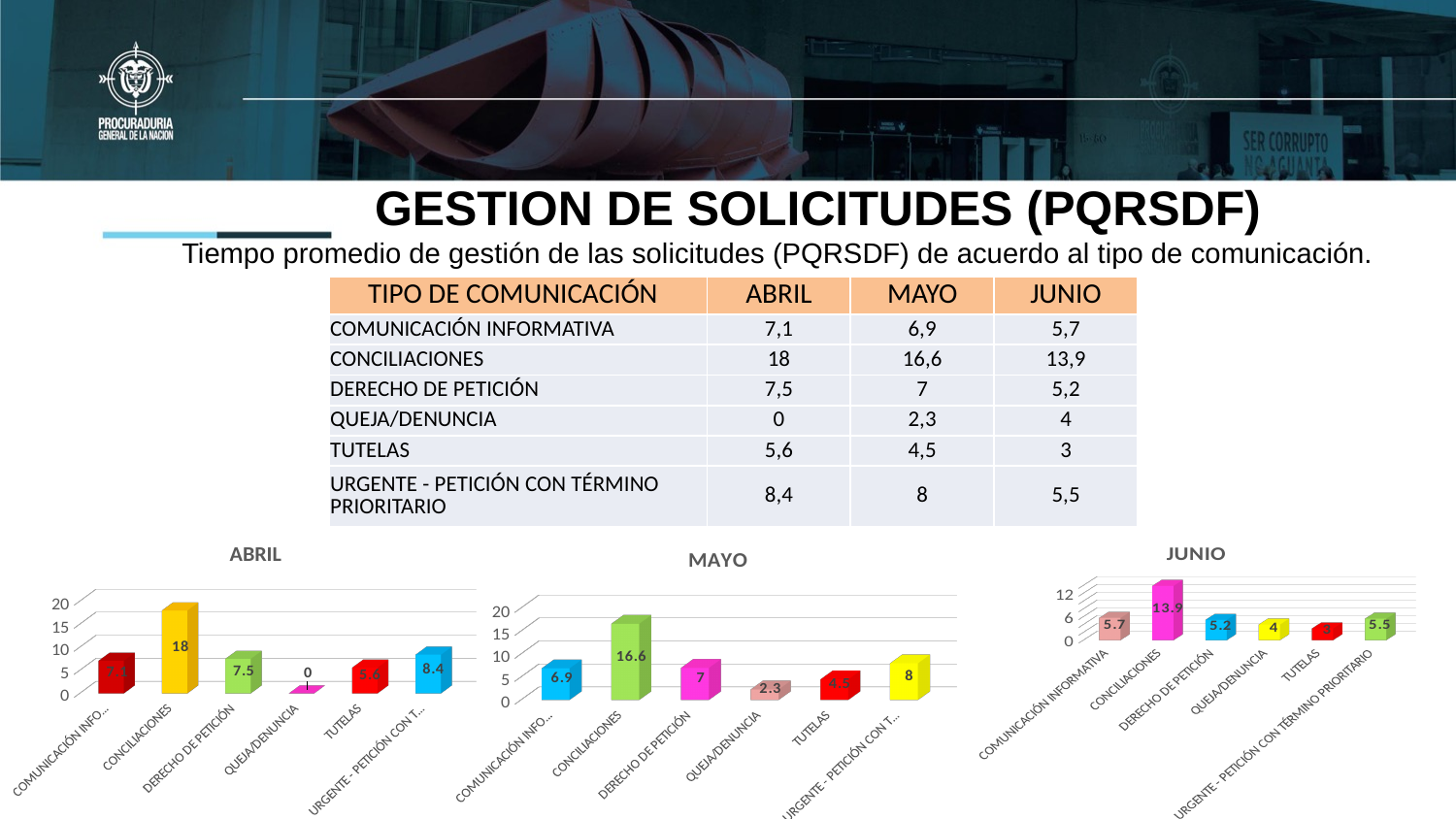
In the MAYO chart, which category has the highest value? CONCILIACIONES In the ABRIL chart, what is the value for CONCILIACIONES? 18 In the MAYO chart, what is the value for CONCILIACIONES? 16.6 In the ABRIL chart, which category has the lowest value? QUEJA/DENUNCIA In the JUNIO chart, is the value for CONCILIACIONES greater or less than 12? greater In the MAYO chart, what is the value for QUEJA/DENUNCIA? 2.3 In the JUNIO chart, which is larger, the value for DERECHO DE PETICIÓN or the value for QUEJA/DENUNCIA? DERECHO DE PETICIÓN In the JUNIO chart, what is the value for CONCILIACIONES? 13.9 In the ABRIL chart, what is the value for URGENTE - PETICIÓN CON TÉRMINO PRIORITARIO? 8.4 How many categories are shown in the ABRIL chart? 6 What kind of chart is the MAYO chart? bar chart In the MAYO chart, what is the difference between the values for CONCILIACIONES and DERECHO DE PETICIÓN? 9.6